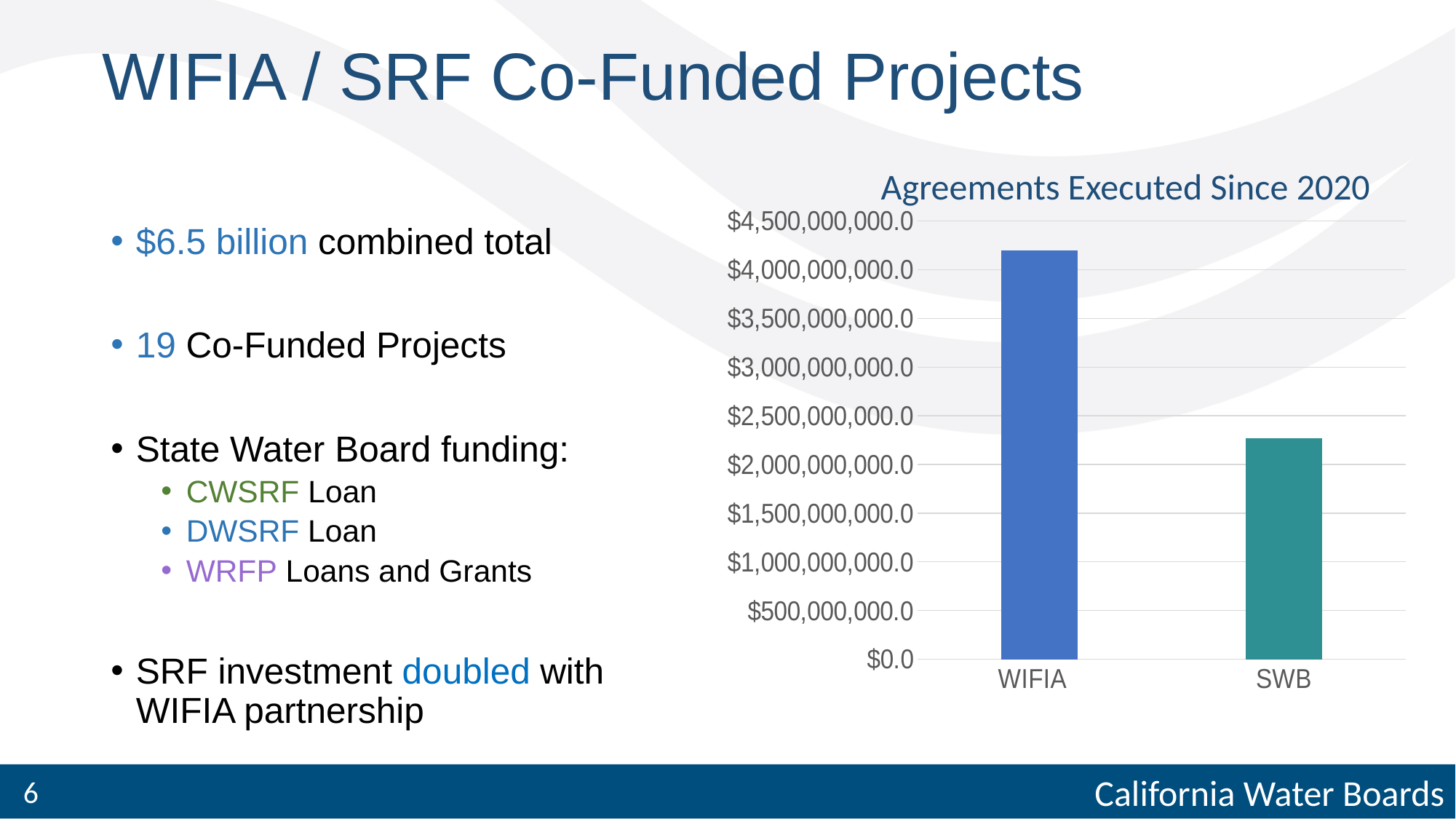
Which is larger, the value for WIFIA or the value for SWB? WIFIA Is the value for WIFIA greater or less than $4,000,000,000.0? greater What are the two categories labelled on the x axis of the chart? WIFIA and SWB Is the value for SWB greater or less than $2,500,000,000.0? less Which category has the lowest value in the chart? SWB What is the highest value labelled on the y axis of the chart? $4,500,000,000.0 Is the value for SWB greater or less than $2,000,000,000.0? greater What kind of chart is shown on the slide? bar chart What is the title of the chart? Agreements Executed Since 2020 How many categories are shown on the x axis of the chart? 2 Which category has the highest value in the chart? WIFIA